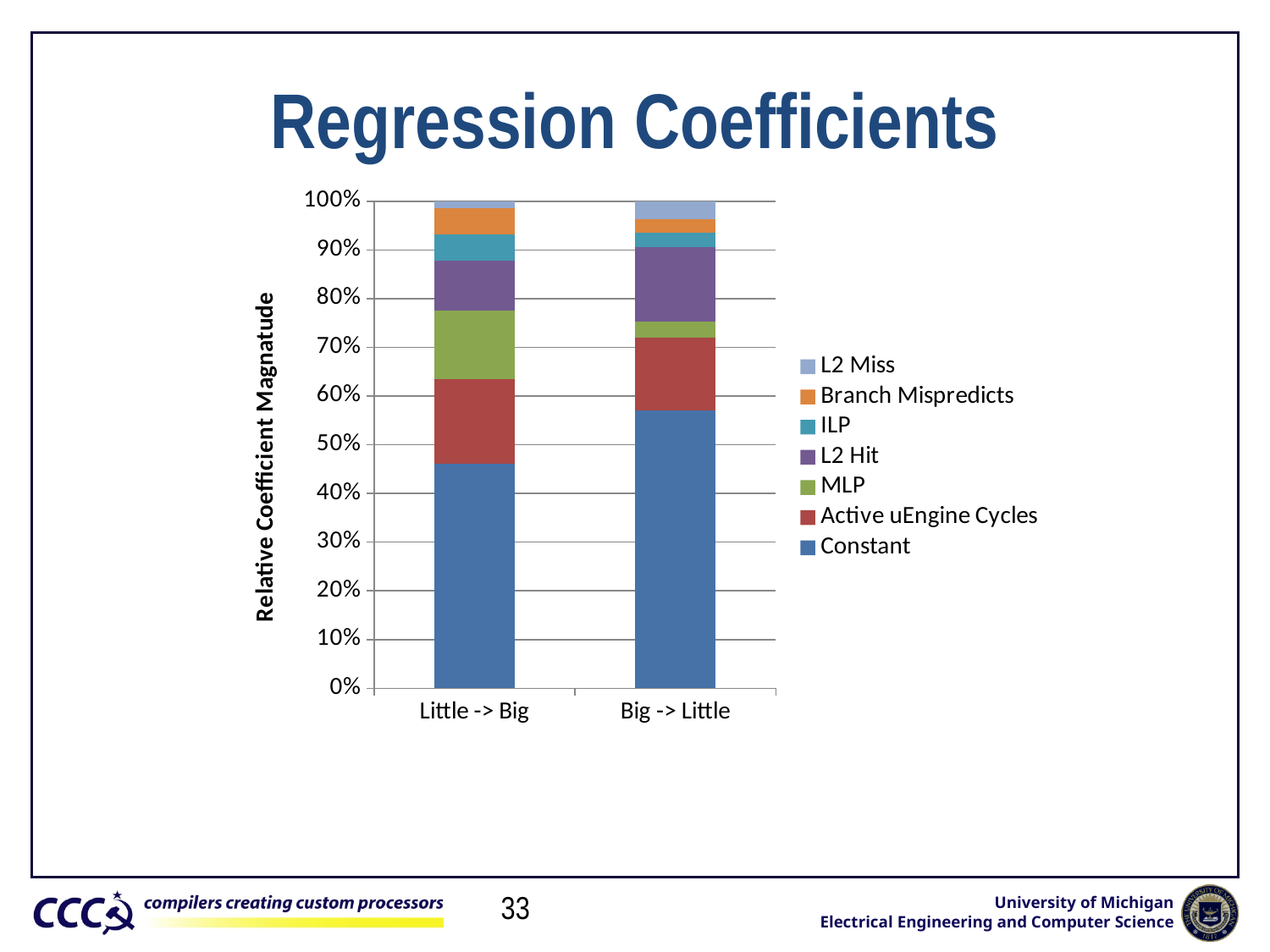
Which category has the larger L2 Miss segment, Little -> Big or Big -> Little? Big -> Little What kind of chart is shown on the slide? stacked bar chart What is the total height of the Big -> Little stacked bar? 100% How many categories are shown on the x axis? 2 Which category has the larger MLP segment, Little -> Big or Big -> Little? Little -> Big Which series is the largest segment in the Little -> Big bar? Constant Is the Constant value for Big -> Little greater or less than 50%? greater What is the label of the y axis? Relative Coefficient Magnatude Is the Constant value for Little -> Big greater or less than 50%? less How many series does the legend list? 7 What is the title of the chart? Regression Coefficients Which category has the larger Constant segment, Little -> Big or Big -> Little? Big -> Little